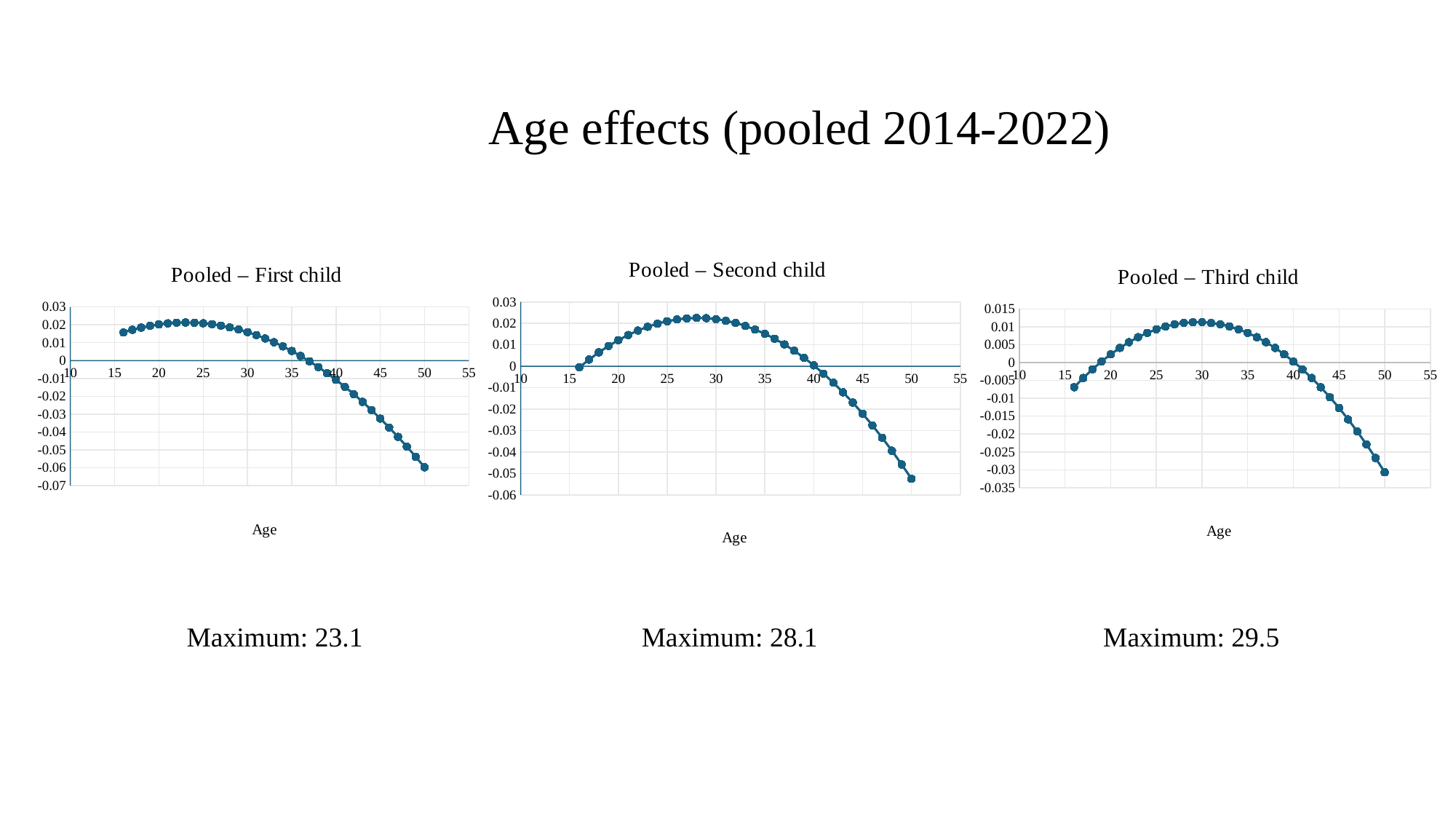
In the 'Pooled – Second child' chart, which is larger: the value at age 25 or the value at age 45? age 25 In the 'Pooled – First child' chart, is the value at age 50 greater or less than -0.05? less In the 'Pooled – First child' chart, do the values rise or fall between age 40 and age 50? fall In the 'Pooled – Third child' chart, do the values rise or fall between age 16 and age 25? rise What is the x-axis label on the 'Pooled – First child' chart? Age In the 'Pooled – Second child' chart, is the value at age 50 greater or less than -0.04? less In the 'Pooled – Third child' chart, is the value at age 50 greater or less than -0.02? less What kind of chart is the 'Pooled – First child' chart? line chart with markers What is the title of the middle chart on the slide? Pooled – Second child